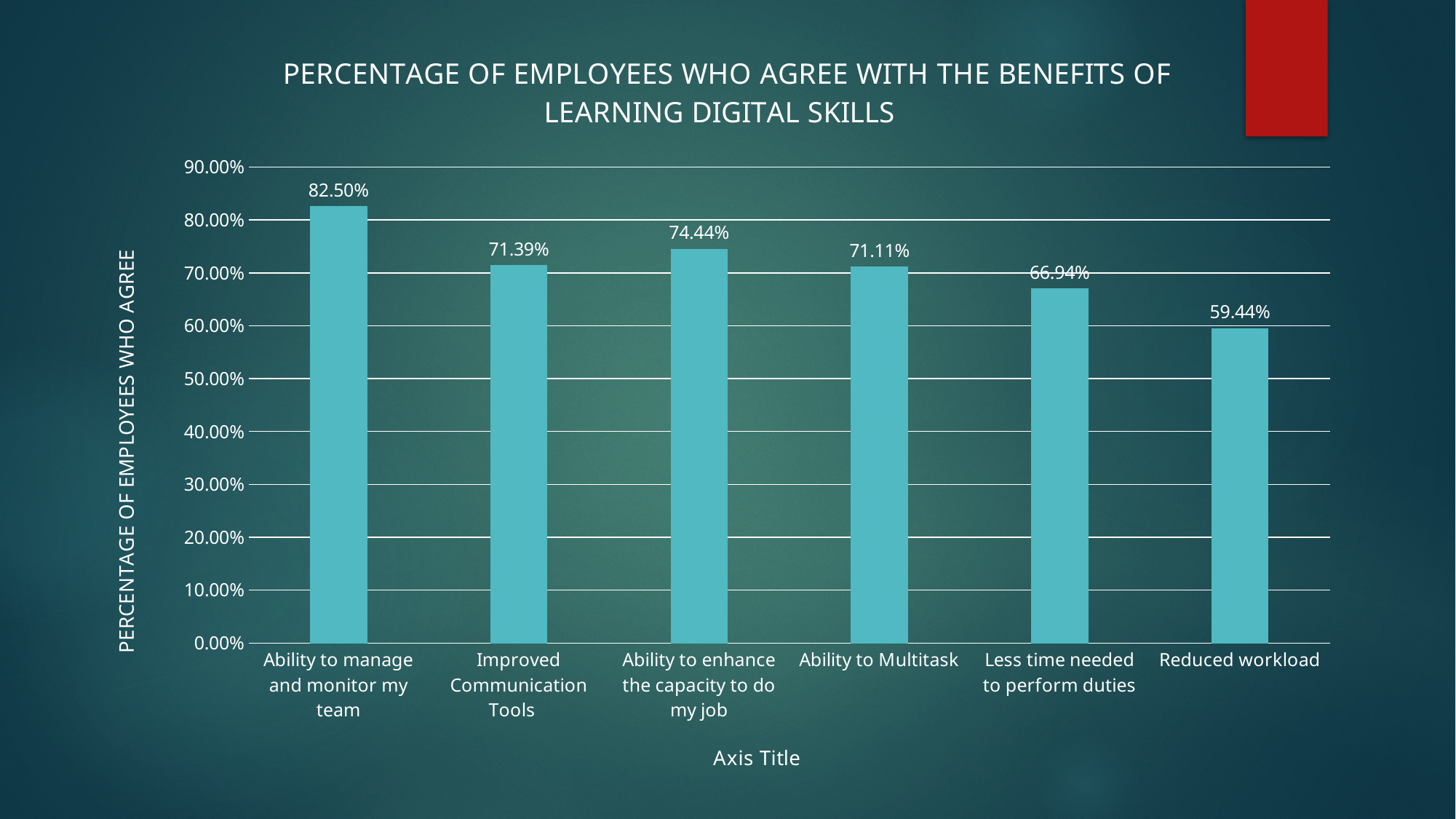
What is the difference between the values for "Ability to enhance the capacity to do my job" and "Ability to Multitask"? 3.33% Which is larger, the value for "Improved Communication Tools" or the value for "Less time needed to perform duties"? Improved Communication Tools What is the label on the vertical axis of the chart? PERCENTAGE OF EMPLOYEES WHO AGREE What is the difference between the values for "Ability to manage and monitor my team" and "Reduced workload"? 23.06% What is the value for "Reduced workload"? 59.44% Which category has the highest percentage of employees who agree? Ability to manage and monitor my team Is the value for "Ability to Multitask" greater or less than 70.00%? greater How many categories are shown on the chart? 6 What is the value for "Less time needed to perform duties"? 66.94% Which category has the lowest percentage of employees who agree? Reduced workload What kind of chart is shown on the slide? Bar chart What percentage of employees agree with "Ability to manage and monitor my team"? 82.50%